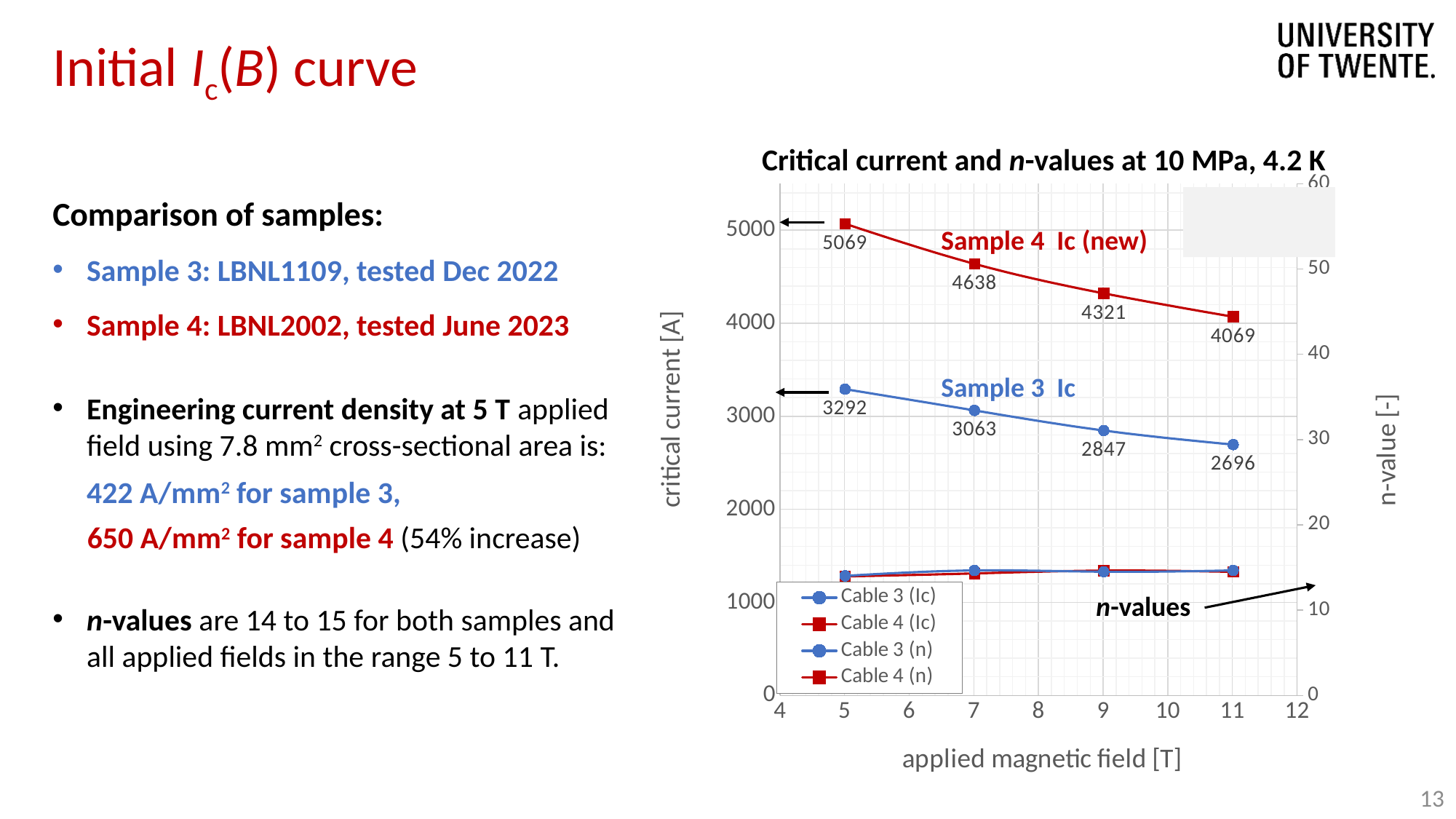
What is the critical current of Cable 3 (Ic) at 7 T? 3063 How many series does the legend list? 4 What type of chart is shown on the slide? Line chart At which applied magnetic field is the Cable 3 (Ic) value highest? 5 T What is the critical current of Cable 4 (Ic) at 9 T? 4321 By how much does the Cable 4 (Ic) value drop between 5 T and 11 T? 1000 At which applied magnetic field is the Cable 4 (Ic) value lowest? 11 T What is the difference between the Cable 4 (Ic) and Cable 3 (Ic) values at 5 T? 1777 What is the critical current of Cable 4 (Ic) at an applied magnetic field of 5 T? 5069 How do the critical current values change as the applied magnetic field increases from 5 T to 11 T? They fall Which is larger at 9 T, the Cable 3 (Ic) value or the Cable 4 (Ic) value? Cable 4 (Ic) What is the critical current of Cable 3 (Ic) at an applied magnetic field of 11 T? 2696